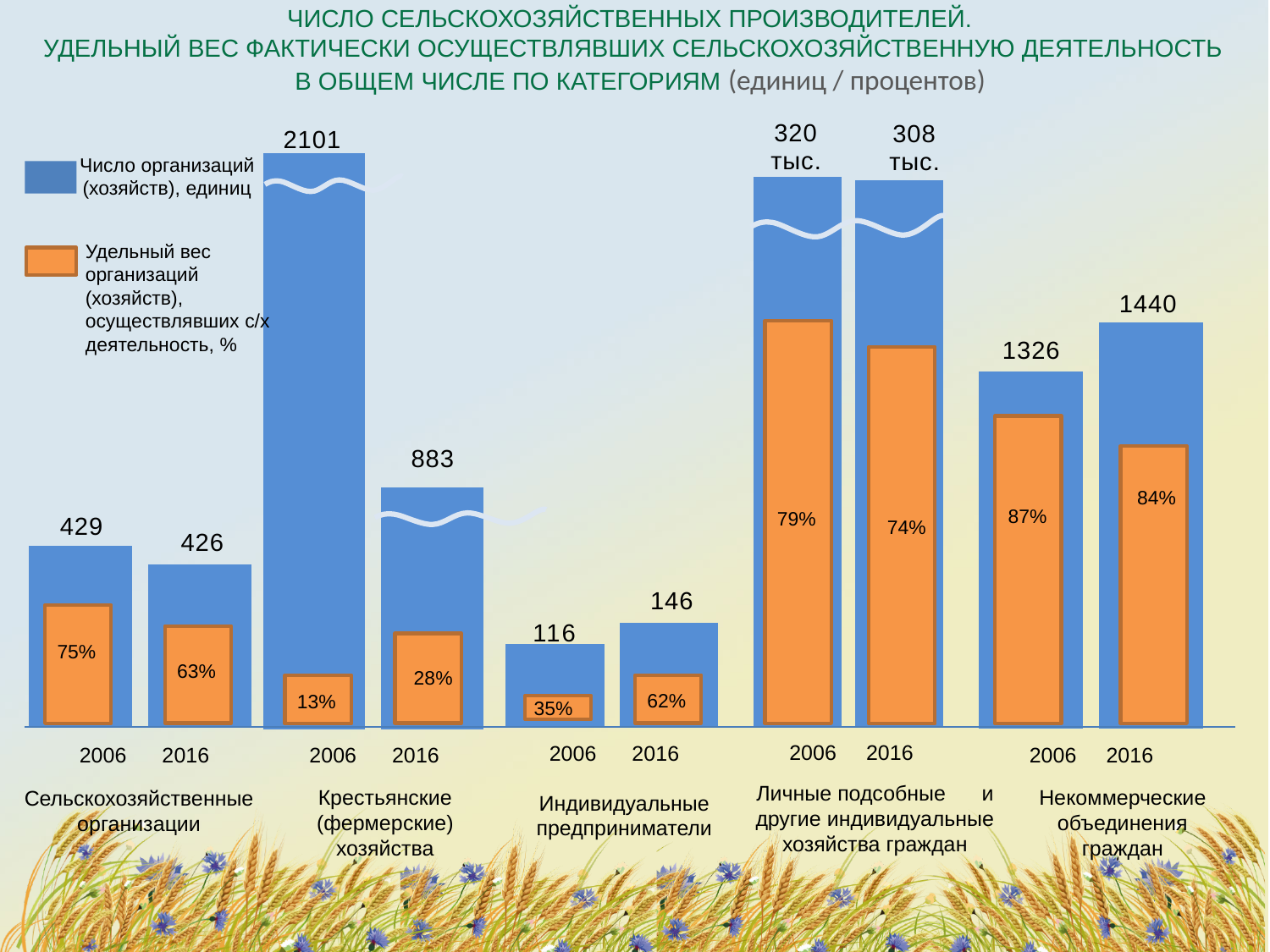
What share of non-commercial associations of citizens (Некоммерческие объединения граждан) carried out agricultural activity in 2006? 87% What was the number of individual entrepreneurs (Индивидуальные предприниматели) in 2016? 146 Which category and year has the lowest share of organizations actually carrying out agricultural activity? Крестьянские (фермерские) хозяйства, 2006 (13%) How many series does the legend list? 2 Which is larger: the number of non-commercial associations of citizens in 2006 or in 2016? 2016 (1440) What type of chart is shown on the slide? Bar chart What share of peasant (farm) holdings (Крестьянские (фермерские) хозяйства) actually carried out agricultural activity in 2016? 28% What was the number of personal subsidiary and other individual holdings of citizens (Личные подсобные и другие индивидуальные хозяйства граждан) in 2006? 320 тыс. What was the number of agricultural organizations (Сельскохозяйственные организации) in 2006? 429 Which category has the highest share of organizations carrying out agricultural activity in 2016? Некоммерческие объединения граждан (84%) How many categories of agricultural producers are shown on the chart? 5 By how much did the number of peasant (farm) holdings (Крестьянские (фермерские) хозяйства) decrease from 2006 to 2016? 1218